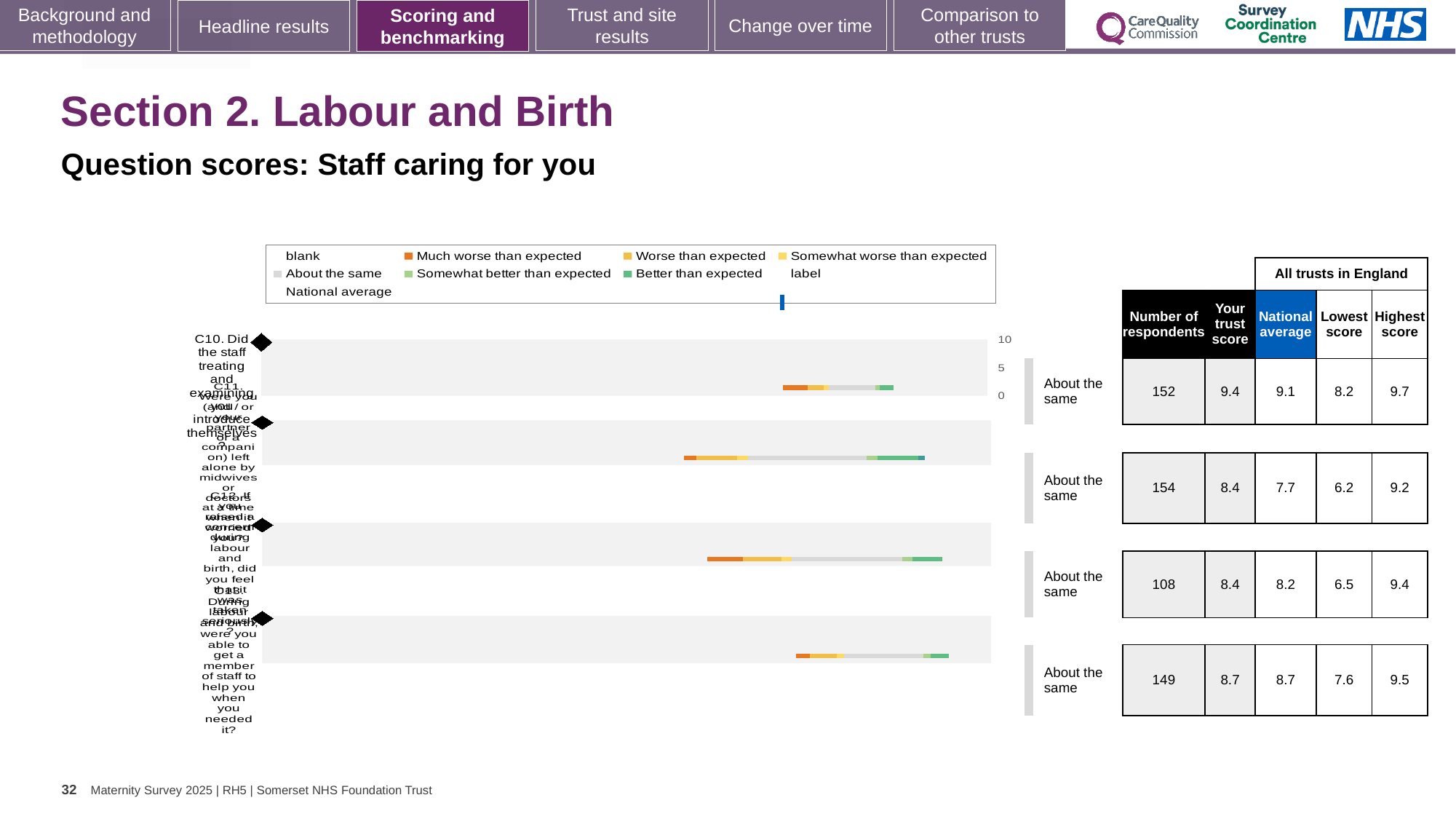
What benchmark category is shown for all four questions next to the chart? About the same For the second row (C11), what is the difference between the trust score (8.4) and the national average (7.7)? 0.7 How many question rows (C10 to C13) are plotted in the chart? 4 For the first row (C10), which is larger: the trust score or the national average? the trust score (9.4) In the table beside the chart, what is the number of respondents for the first row (C10)? 152 In the table beside the chart, what is the 'Your trust score' for the second row (C11)? 8.4 Which legend entry is shown in orange? Much worse than expected What kind of chart is shown on the slide? bar chart Which row in the table has the highest number of respondents? C11 (154) What is the lowest score among all trusts in England for the third row (C12)? 6.5 Which row in the table has the lowest number of respondents? C12 (108) What is the highest score among all trusts in England for the fourth row (C13)? 9.5